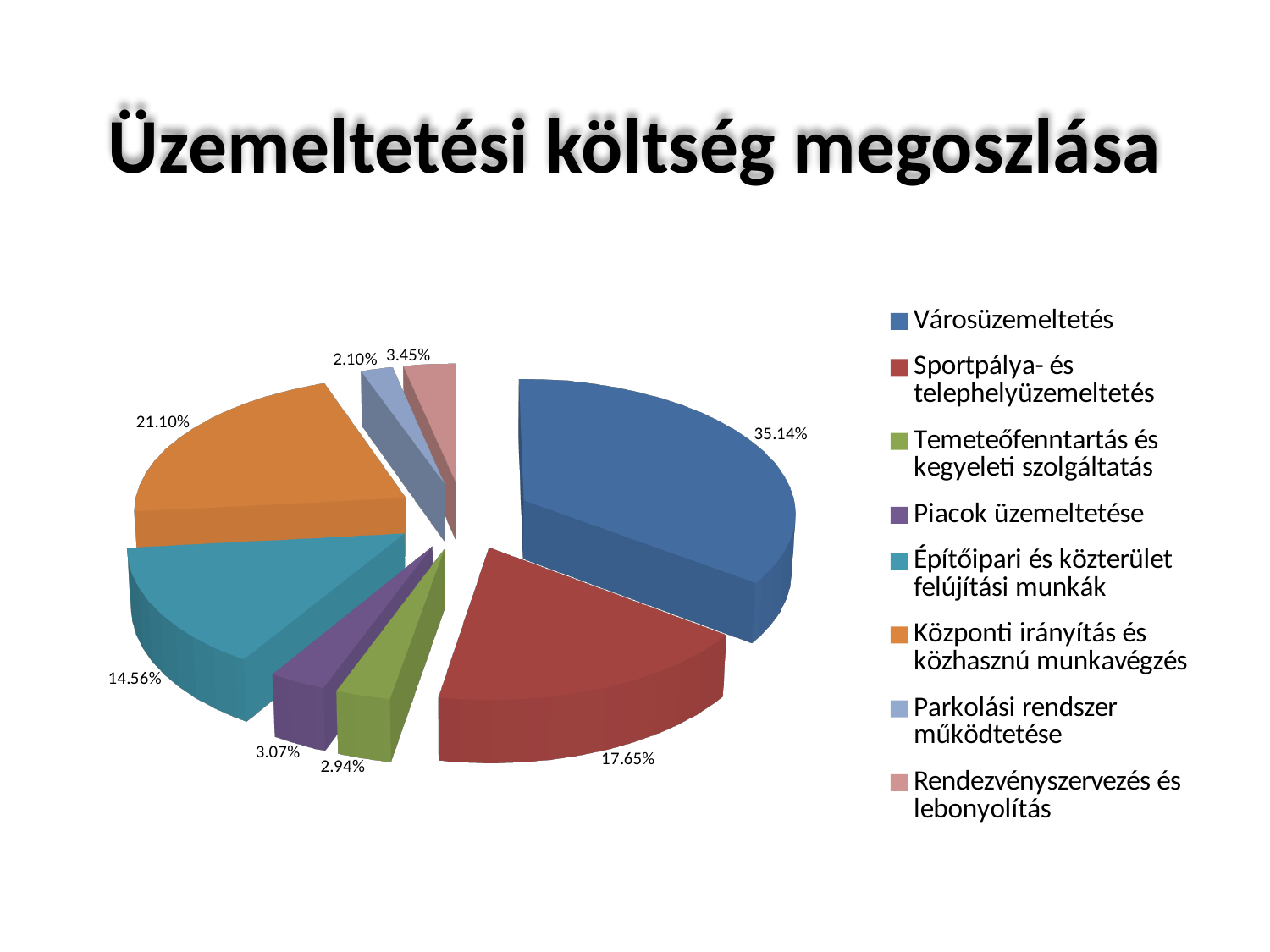
What share of the pie does Városüzemeltetés have? 35.14% What is the value for Építőipari és közterület felújítási munkák? 14.56% What is the title of the chart on the slide? Üzemeltetési költség megoszlása What colour is the slice for Rendezvényszervezés és lebonyolítás? Pink What is the value for Sportpálya- és telephelyüzemeltetés? 17.65% Which category has the largest share of the pie? Városüzemeltetés What is the difference between the shares of Városüzemeltetés and Sportpálya- és telephelyüzemeltetés? 17.49% How many slices does the pie chart have? 8 Which category has the smallest share of the pie? Parkolási rendszer működtetése Which is larger, the share for Piacok üzemeltetése or the share for Temeteőfenntartás és kegyeleti szolgáltatás? Piacok üzemeltetése What kind of chart is shown on the slide? Pie chart What is the value for Központi irányítás és közhasznú munkavégzés? 21.10%